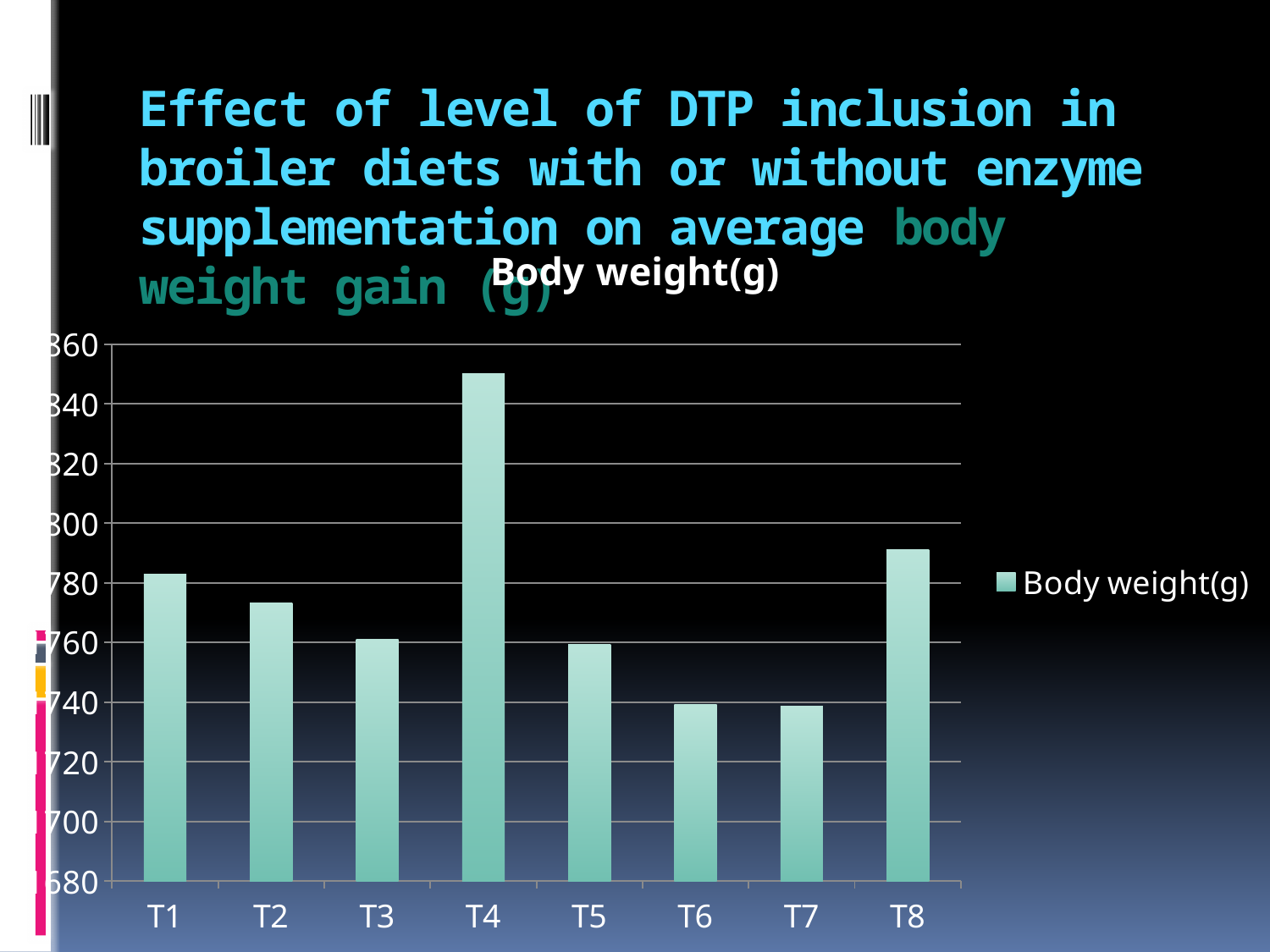
Which is larger, the value for T4 or the value for T8? T4 Is the value for T4 greater or less than 840? greater Which category has the highest body weight? T4 What kind of chart is shown on the slide? bar chart Is the value for T8 greater or less than 780? greater How many series does the chart's legend list? 1 Is the value for T5 greater or less than 780? less How many categories are plotted on the x axis of the chart? 8 Which is larger, the value for T2 or the value for T6? T2 What series name is shown in the chart's legend? Body weight(g) What is the title of the chart? Body weight(g)